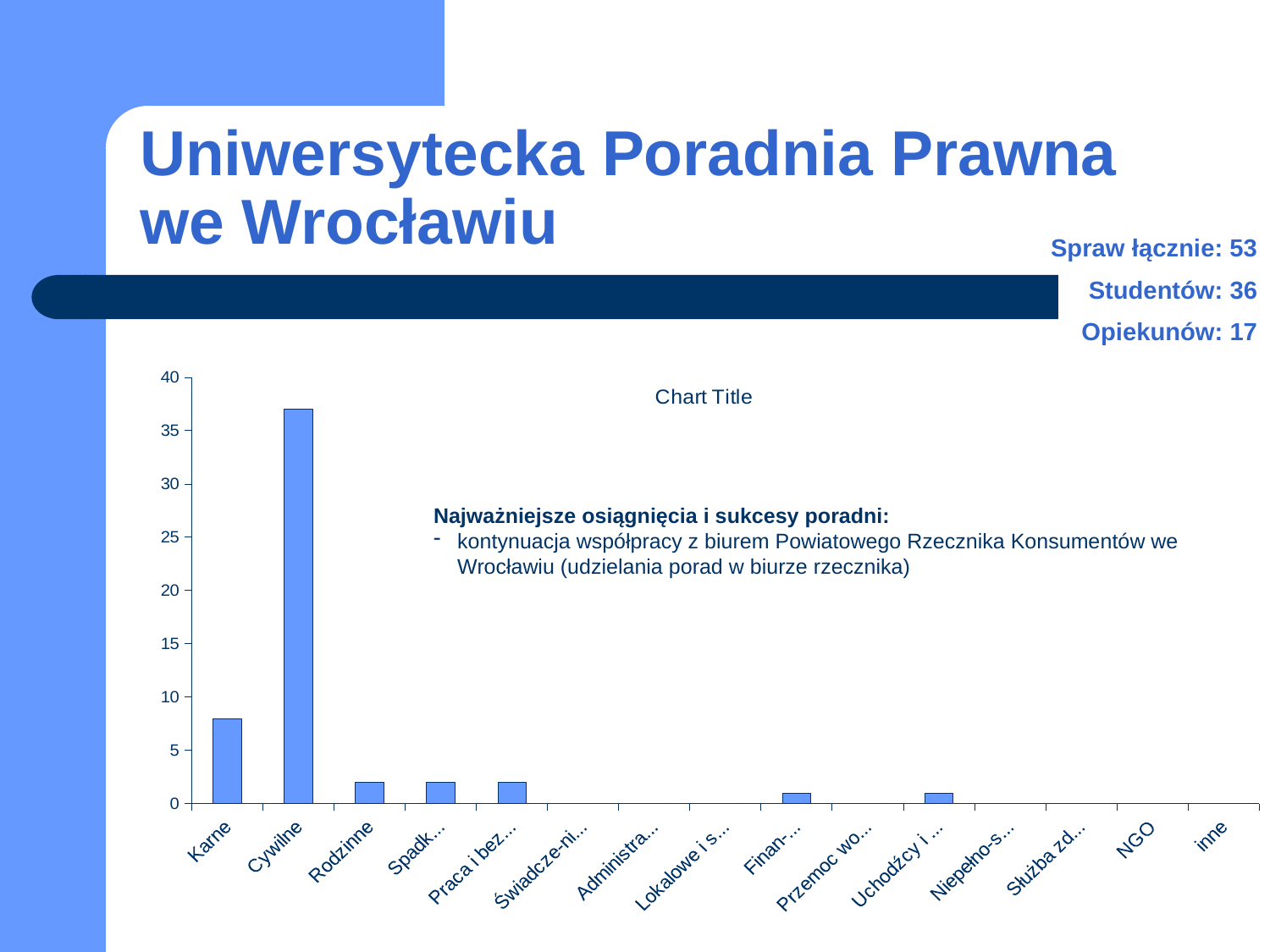
Which is larger, the value for Karne or the value for Rodzinne? Karne Which category has the highest bar in the chart? Cywilne Is the value for Rodzinne greater or less than 5? less How many categories are shown on the x axis of the chart? 15 Is the value for Cywilne greater or less than 35? greater Is the value for Karne greater or less than 5? greater What kind of chart is shown on the slide? bar chart What is the highest value shown on the chart's y axis? 40 What is the title shown on the chart? Chart Title Which is larger, the value for Karne or the value for Cywilne? Cywilne